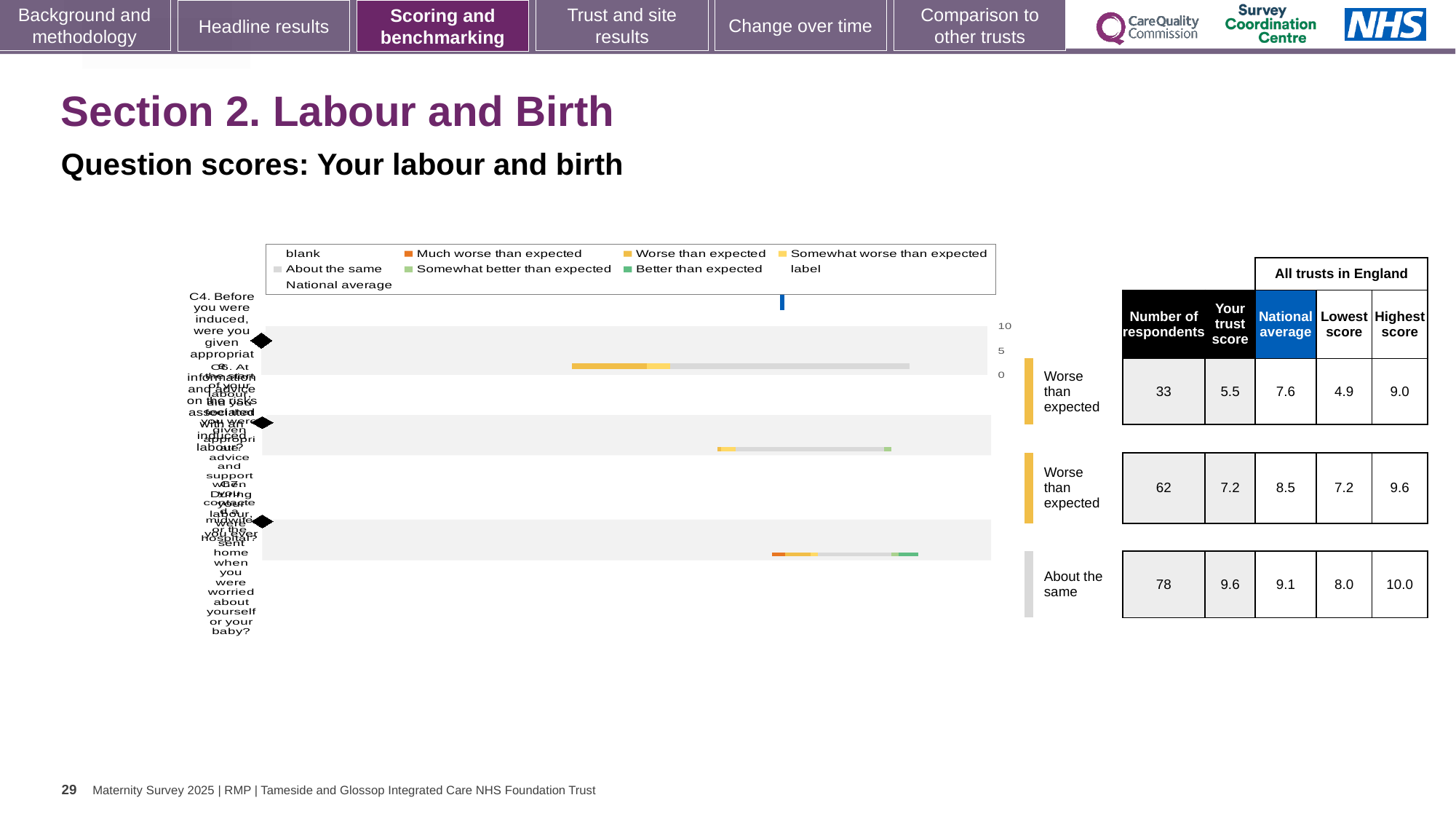
What kind of chart is shown on the slide? bar chart In the table, what is the difference between the national average and the trust score for the first row? 2.1 In the table, which row has the most respondents? the 'About the same' row (78) In the table, what is the trust score for the row rated 'About the same'? 9.6 In the table, what is the number of respondents for the row rated 'About the same'? 78 In the table, what is the trust score for the first row? 5.5 For the row rated 'About the same', which is larger: the trust score or the national average? the trust score How many question rows are plotted in the chart? 3 In the table, what is the national average for the row rated 'About the same'? 9.1 In the table, what is the lowest score for the second row? 7.2 In the table, what is the highest score for the row rated 'About the same'? 10.0 In the table, what is the number of respondents for the first row? 33